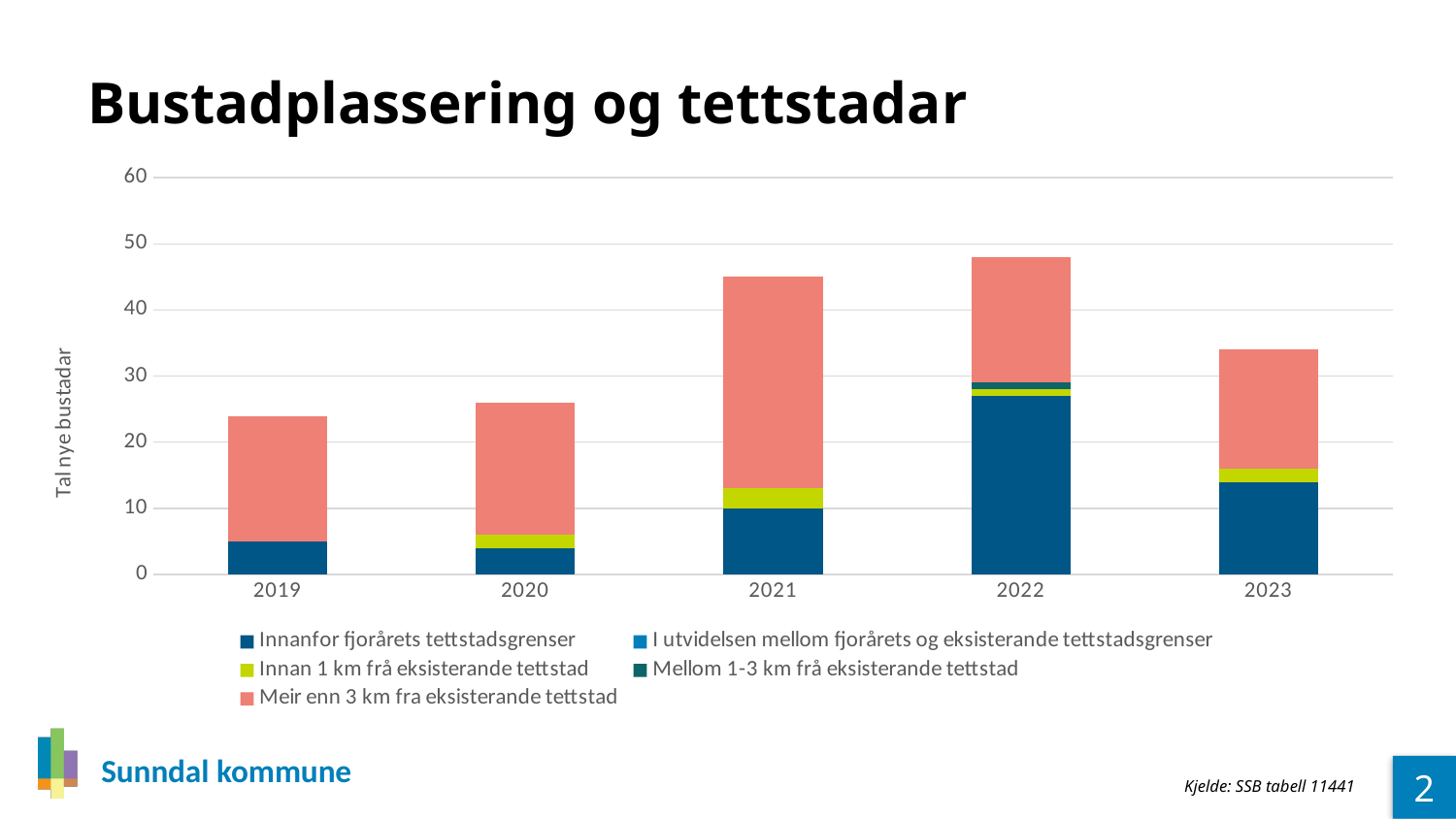
Do the total bar heights rise or fall from 2019 to 2022? rise Is the total for 2022 greater or less than 40? greater What is the label on the y axis of the chart? Tal nye bustadar What is the title of the chart on the slide? Bustadplassering og tettstadar Which year has the highest total bar? 2022 Which year has the larger total bar, 2021 or 2023? 2021 Is the total for 2023 greater or less than 30? greater Is the total for 2020 greater or less than 30? less How many series does the chart legend list? 5 How many years are shown on the x axis of the chart? 5 What kind of chart is shown on the slide? Stacked bar chart